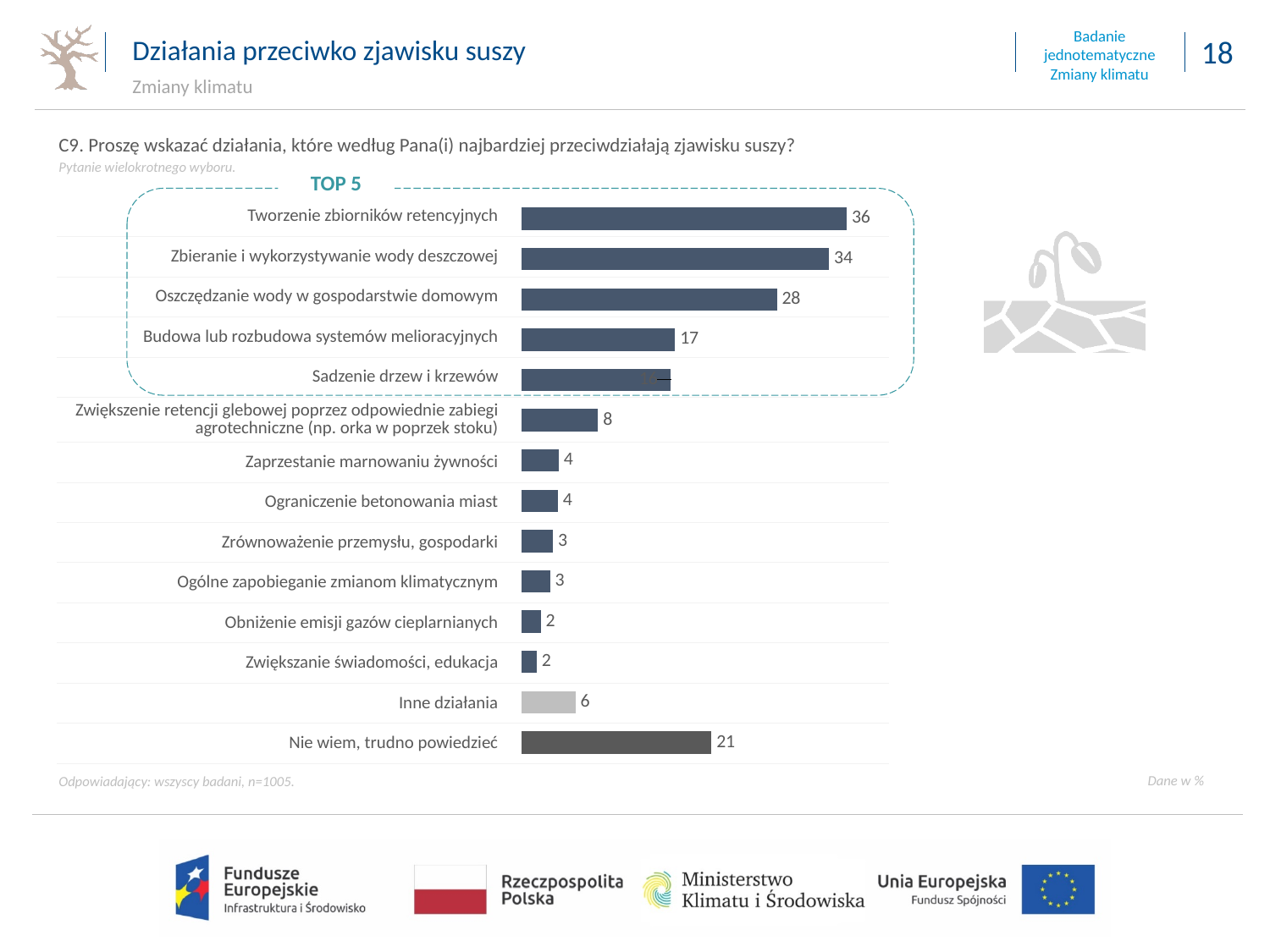
Which is larger: the value for "Nie wiem, trudno powiedzieć" or the value for "Budowa lub rozbudowa systemów melioracyjnych"? Nie wiem, trudno powiedzieć Which category has the highest value in the chart? Tworzenie zbiorników retencyjnych What is the difference between the values for "Budowa lub rozbudowa systemów melioracyjnych" and "Zwiększenie retencji glebowej poprzez odpowiednie zabiegi agrotechniczne"? 9 What value is shown for "Obniżenie emisji gazów cieplarnianych"? 2 How many categories are enclosed in the dashed "TOP 5" box? 5 What is the difference between the values for "Tworzenie zbiorników retencyjnych" and "Oszczędzanie wody w gospodarstwie domowym"? 8 What value is shown for "Zbieranie i wykorzystywanie wody deszczowej"? 34 How many categories are shown in the chart? 14 What value is shown for "Tworzenie zbiorników retencyjnych"? 36 What value is shown for "Nie wiem, trudno powiedzieć"? 21 What value is shown for "Inne działania"? 6 What kind of chart is shown on the slide? Bar chart